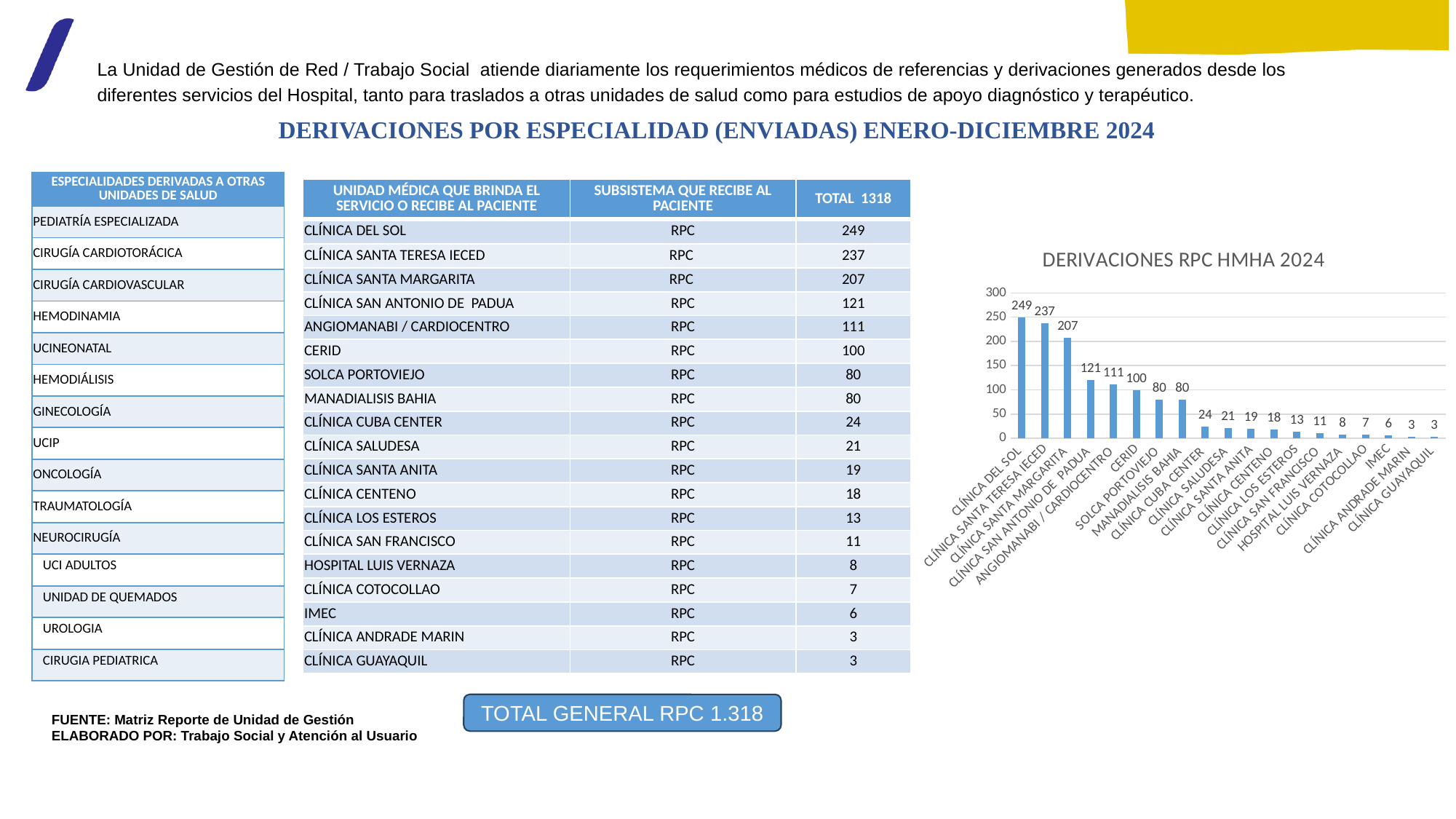
What type of chart is shown under the title DERIVACIONES RPC HMHA 2024? bar chart Which has a larger value in the chart, ANGIOMANABI / CARDIOCENTRO or SOLCA PORTOVIEJO? ANGIOMANABI / CARDIOCENTRO What is the difference between the values for CLÍNICA SANTA MARGARITA and CLÍNICA SAN ANTONIO DE PADUA? 86 In the chart, what is the value for CERID? 100 In the chart, what is the value for HOSPITAL LUIS VERNAZA? 8 How many categories are plotted in the chart? 19 Do the values in the chart rise or fall from left to right along the x axis? fall In the chart, what is the value for CLÍNICA CUBA CENTER? 24 What is the title of the chart on the slide? DERIVACIONES RPC HMHA 2024 In the chart, what is the value for CLÍNICA DEL SOL? 249 Which category has the highest value in the chart? CLÍNICA DEL SOL What is the difference between the values for CLÍNICA DEL SOL and CLÍNICA SANTA TERESA IECED? 12